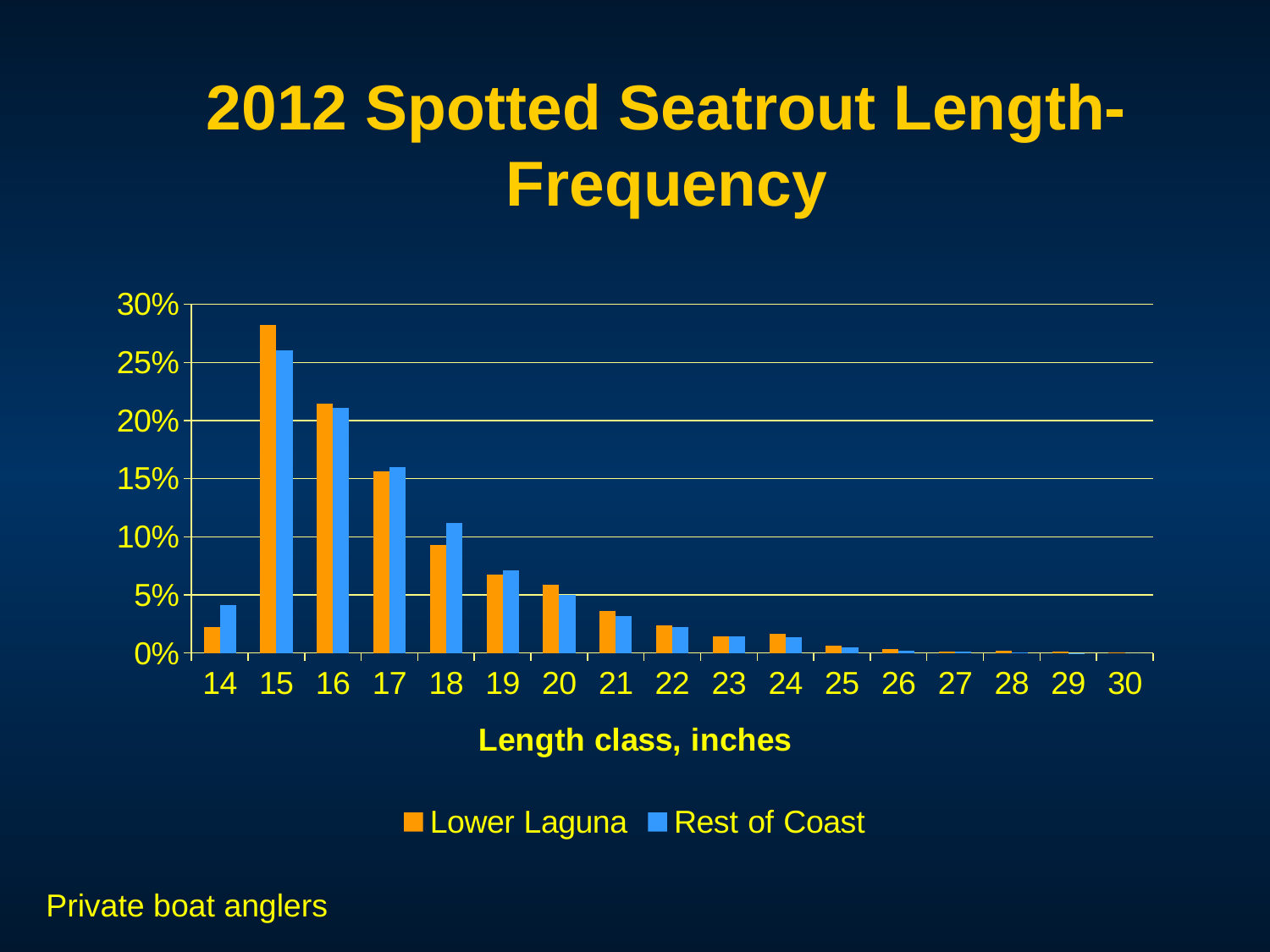
Is the Rest of Coast value for length class 18 greater or less than 10%? greater What kind of chart is shown on the slide? bar chart From length class 15 to length class 30, do the Lower Laguna values rise or fall? fall Which length class has the highest value for Rest of Coast? 15 Is the Lower Laguna value for length class 18 greater or less than 10%? less For length class 14, which series has the larger value, Lower Laguna or Rest of Coast? Rest of Coast Which length class has the highest value for Lower Laguna? 15 Is the Lower Laguna value for length class 14 greater or less than 5%? less For length class 15, which series has the larger value, Lower Laguna or Rest of Coast? Lower Laguna How many length classes are shown on the x axis? 17 How many series does the legend list? 2